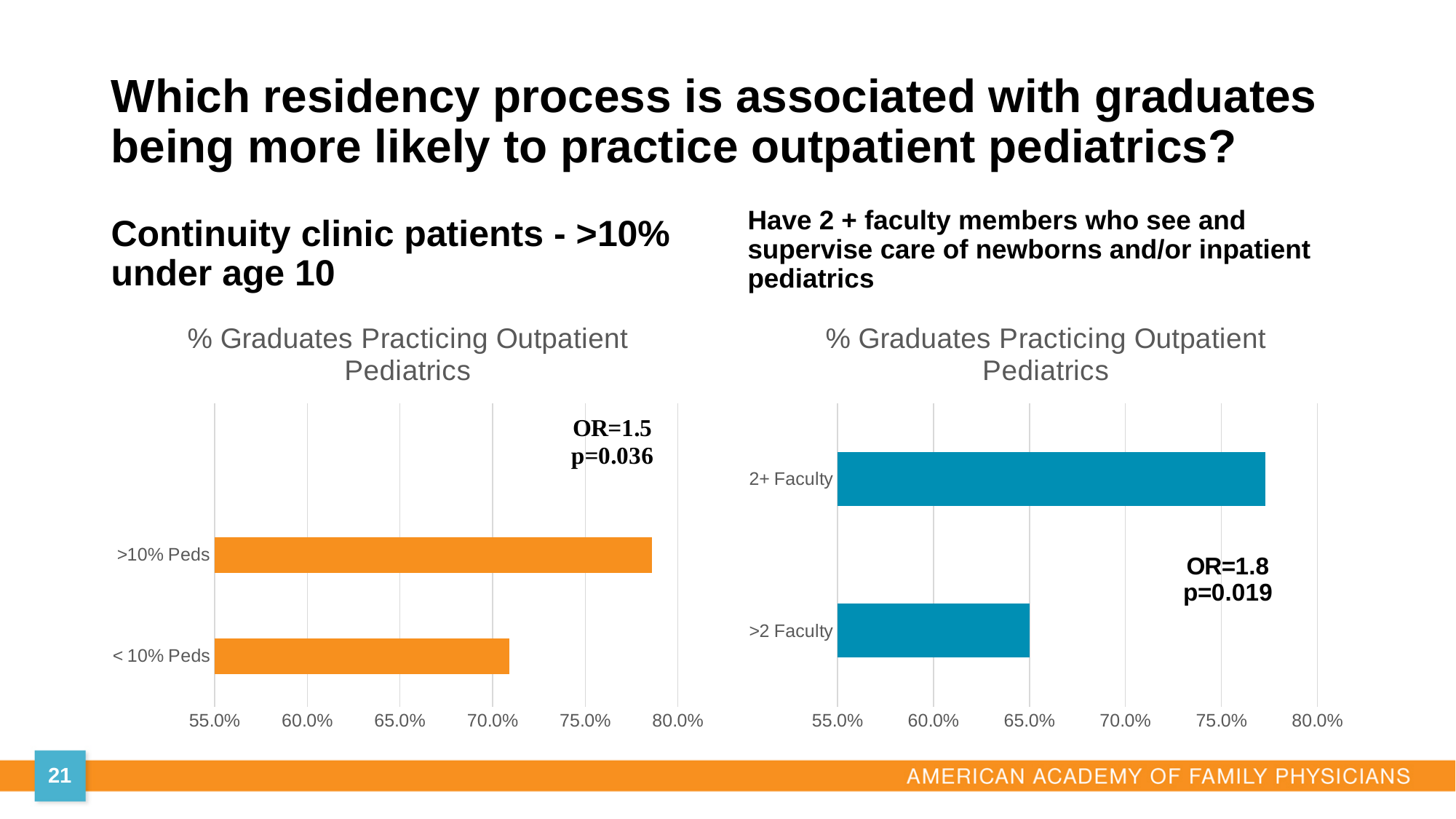
In the left chart, which category has the higher value? >10% Peds In the left chart, which category has the lower value? < 10% Peds What odds ratio is annotated on the right chart? OR=1.8 What p-value is annotated on the left chart? p=0.036 How many categories are shown in the left chart? 2 In the left chart, is the value for < 10% Peds greater or less than 75.0%? less In the right chart, is the value for 2+ Faculty greater or less than 75.0%? greater In the right chart, which category has the higher value? 2+ Faculty In the right chart, is the value for >2 Faculty greater or less than 70.0%? less In the right chart, which is larger: the value for 2+ Faculty or the value for >2 Faculty? 2+ Faculty What type of chart is the left chart on the slide? bar chart